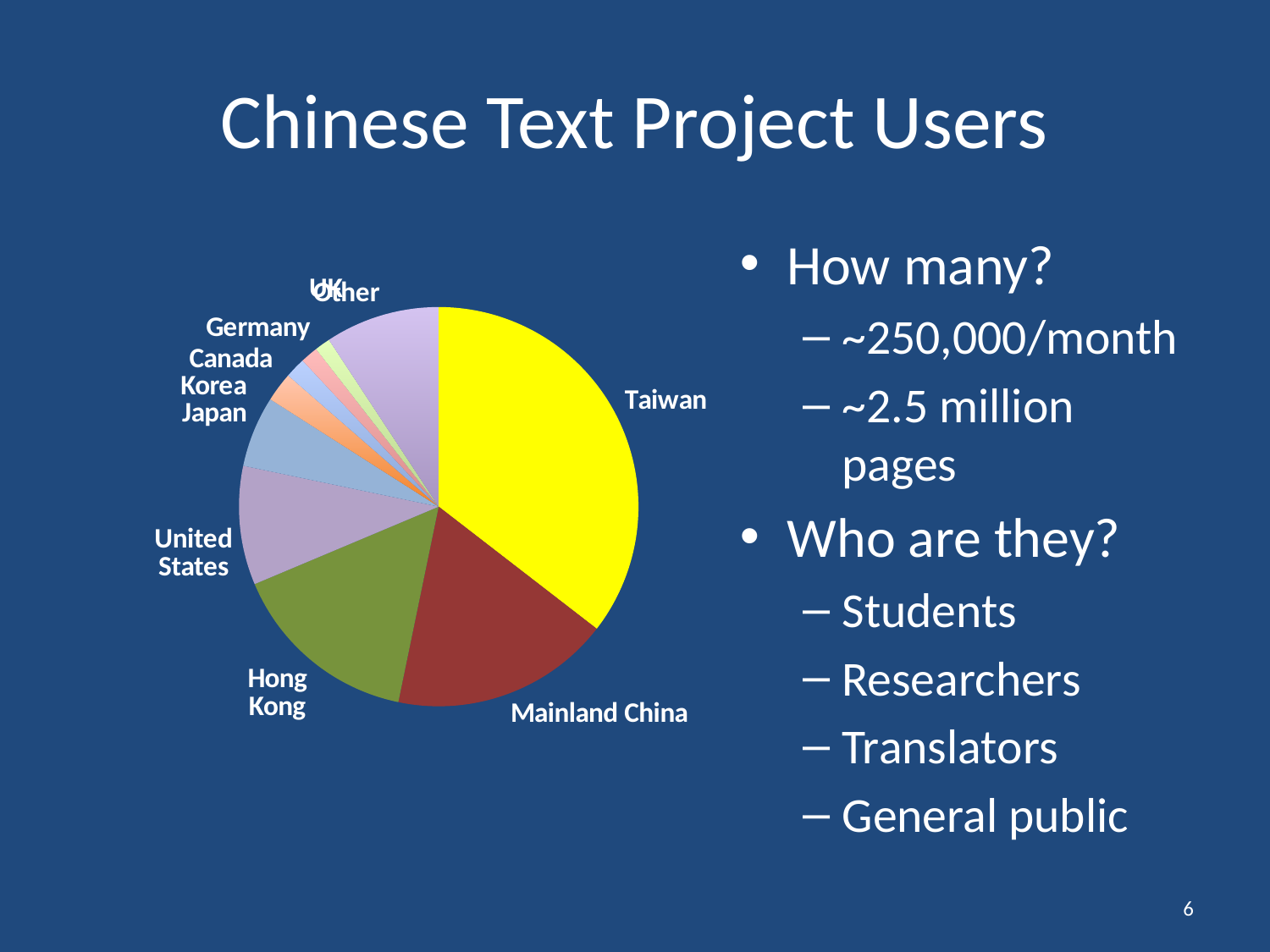
Which slice is larger in the pie chart, Japan or Germany? Japan Which slice is larger in the pie chart, Hong Kong or United States? Hong Kong What kind of chart is shown on the slide? pie chart Which slice is larger in the pie chart, Other or Canada? Other Which slice of the pie chart is the second largest? Mainland China Which category has the largest slice of the pie chart? Taiwan How many slices does the pie chart have? 10 What colour is the Taiwan slice in the pie chart? yellow